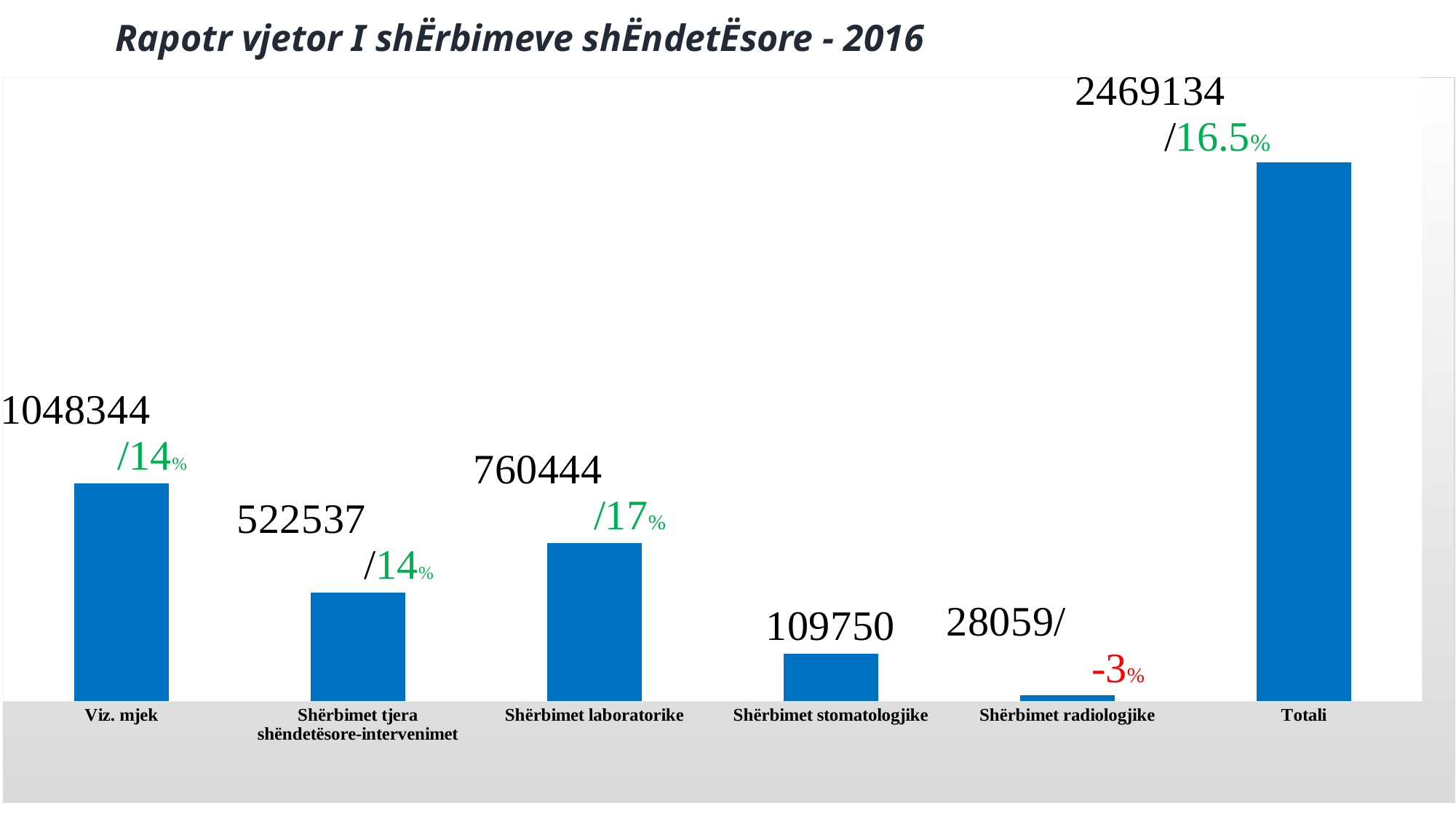
What is the difference between the values for Shërbimet stomatologjike and Shërbimet radiologjike? 81691 Which category has the tallest bar? Totali Which is larger, the value for Shërbimet tjera shëndetësore-intervenimet or the value for Shërbimet laboratorike? Shërbimet laboratorike What value is shown for Shërbimet stomatologjike? 109750 What value is shown for Shërbimet laboratorike? 760444 What percentage change is shown next to Totali? 16.5% What value is shown for Shërbimet radiologjike? 28059 Which category has the smallest value? Shërbimet radiologjike What value is shown for Viz. mjek? 1048344 What is the difference between the values for Viz. mjek and Shërbimet laboratorike? 287900 What type of chart is shown on the slide? Bar chart How many categories are shown on the x axis? 6